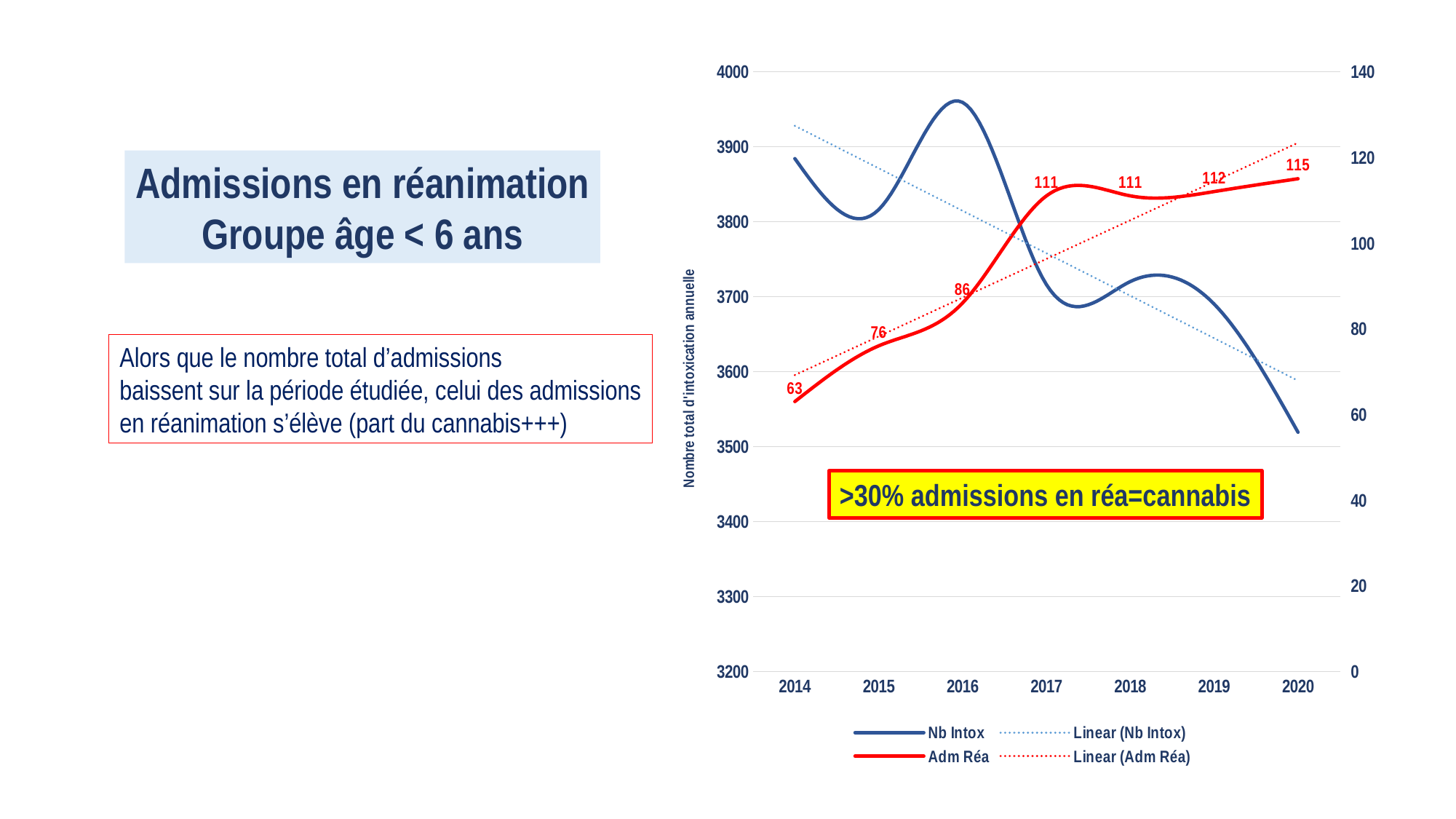
Which year has the larger Adm Réa value, 2015 or 2016? 2016 In which year is Adm Réa highest? 2020 What is the difference between the Adm Réa values for 2020 and 2014? 52 Is the Nb Intox value for 2016 greater or less than 3900? greater In which year is Adm Réa lowest? 2014 How many entries does the legend list? 4 Is the Nb Intox value for 2020 greater or less than 3600? less How many years are shown on the x axis? 7 What is the value of Adm Réa in 2020? 115 What is the value of Adm Réa in 2014? 63 What is the difference between the Adm Réa values for 2017 and 2016? 25 What is the value of Adm Réa in 2016? 86